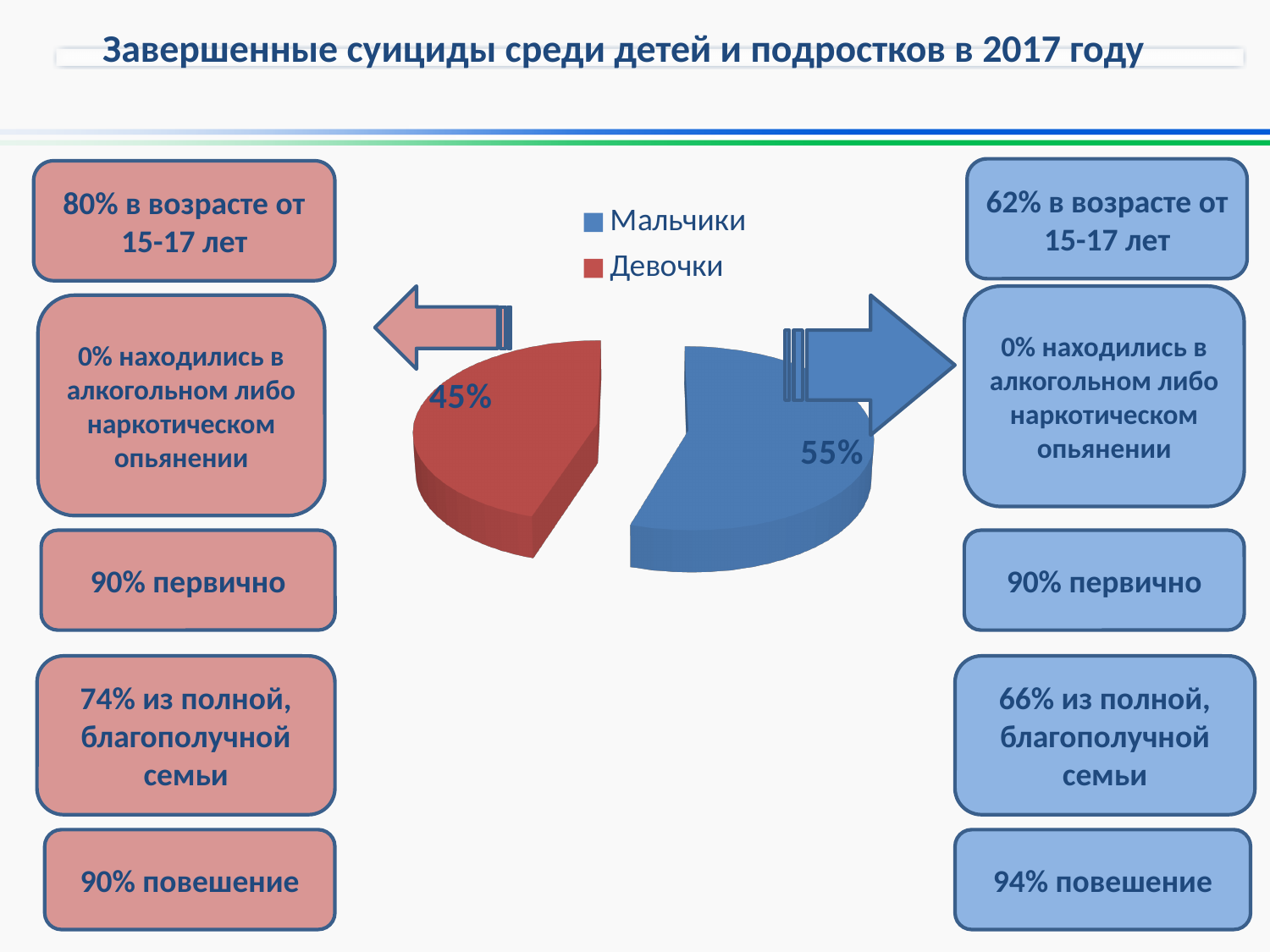
How many slices does the pie chart have? 2 What is the share of the pie taken by the Девочки slice? 45% What colour represents Мальчики in the chart legend? Blue How many entries does the chart legend list? 2 What share of the pie chart is labelled for Девочки? 45% What kind of chart is shown on the slide? Pie chart Which category has the largest slice in the pie chart? Мальчики Which category has the smallest slice in the pie chart? Девочки What colour represents Девочки in the chart legend? Red What share of the pie chart is labelled for Мальчики? 55% By how many percentage points does the Мальчики slice exceed the Девочки slice? 10 percentage points Which slice is larger, Мальчики or Девочки? Мальчики